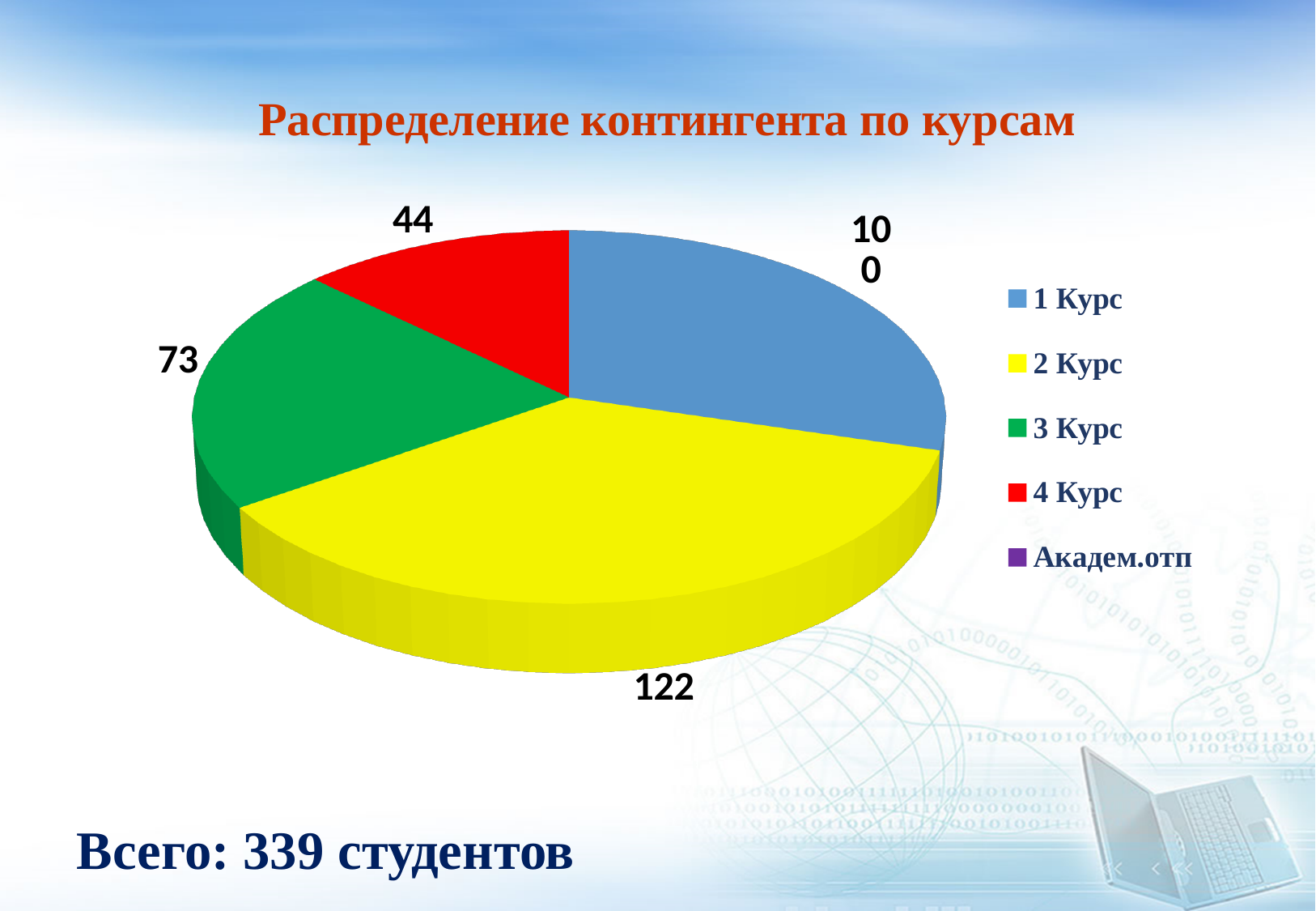
What is the value for 4 Курс in the pie chart? 44 What is the value for 3 Курс in the pie chart? 73 What is the value for 1 Курс in the pie chart? 100 What is the difference between the values for 3 Курс and 4 Курс? 29 Which course has the largest slice in the pie chart? 2 Курс How many entries does the legend list? 5 What is the value for 2 Курс in the pie chart? 122 Which is larger, the value for 3 Курс or the value for 4 Курс? 3 Курс Which of the labelled slices has the smallest value? 4 Курс What type of chart is shown on the slide? pie chart What is the title of the chart? Распределение контингента по курсам What is the difference between the values for 2 Курс and 1 Курс? 22